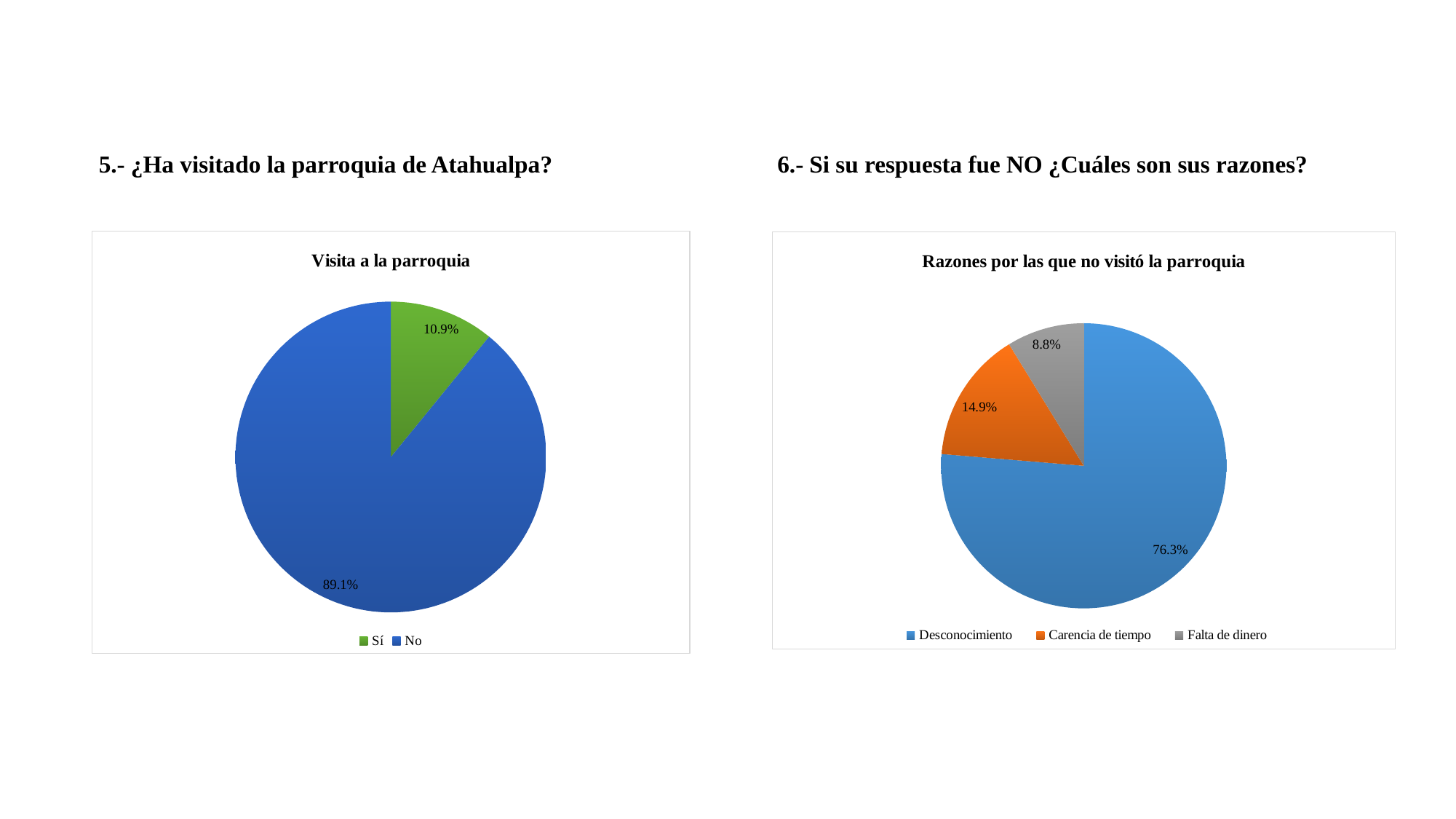
In the 'Visita a la parroquia' chart, what is the difference between the 'No' and 'Sí' percentages? 78.2% In the 'Razones por las que no visitó la parroquia' chart, what percentage is shown for 'Carencia de tiempo'? 14.9% In the 'Razones por las que no visitó la parroquia' chart, which category has the smallest slice? Falta de dinero In the 'Razones por las que no visitó la parroquia' chart, which is larger: 'Carencia de tiempo' or 'Falta de dinero'? Carencia de tiempo How many categories does the legend of the 'Visita a la parroquia' chart list? 2 In the 'Visita a la parroquia' chart, what percentage is shown for 'No'? 89.1% In the 'Visita a la parroquia' chart, what percentage is shown for 'Sí'? 10.9% How many categories does the legend of the 'Razones por las que no visitó la parroquia' chart list? 3 In the 'Razones por las que no visitó la parroquia' chart, what is the difference between 'Carencia de tiempo' and 'Falta de dinero'? 6.1% What kind of chart is 'Visita a la parroquia'? Pie chart In the 'Razones por las que no visitó la parroquia' chart, what percentage is shown for 'Desconocimiento'? 76.3% In the 'Visita a la parroquia' chart, which category has the largest slice? No